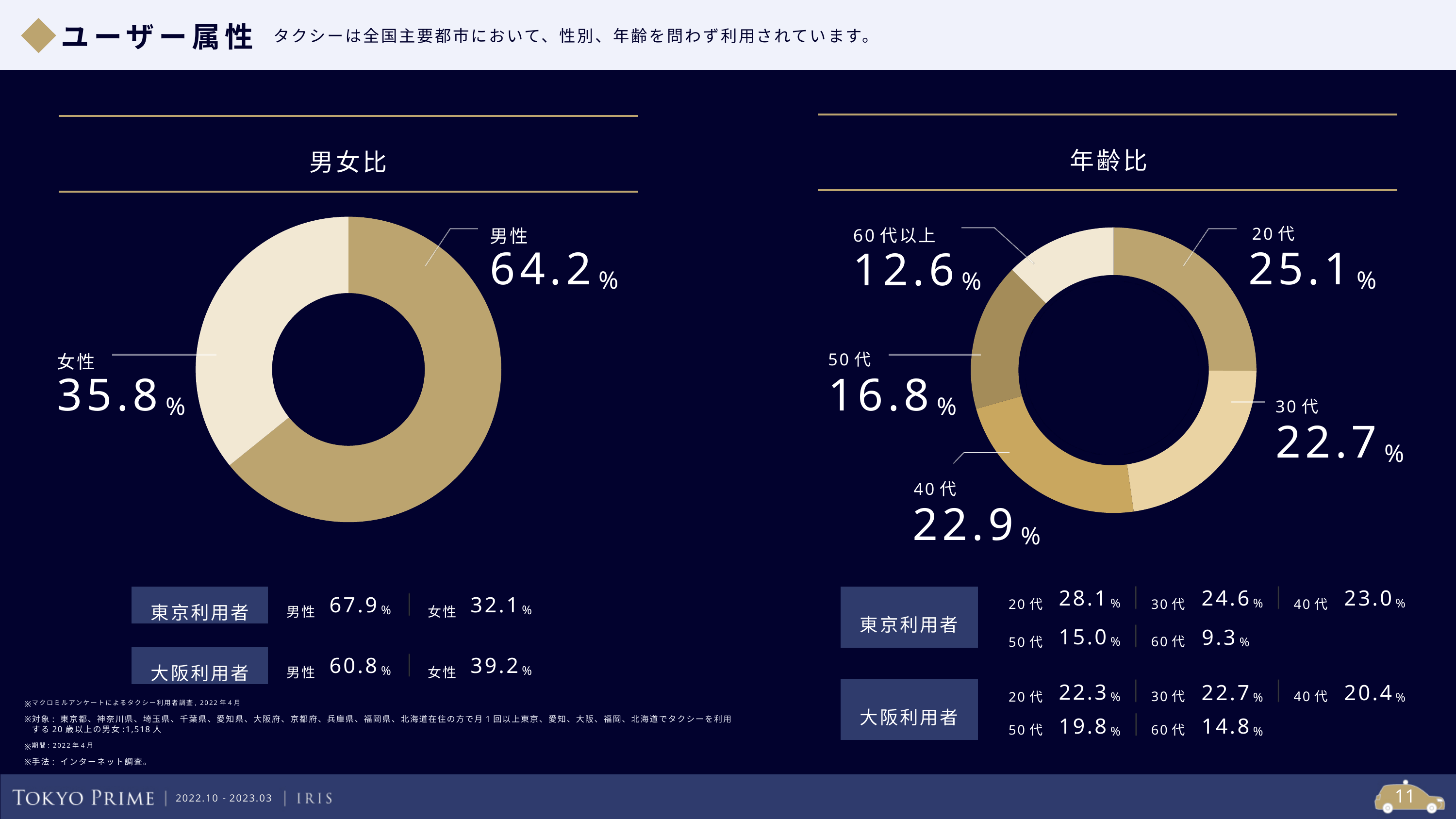
In the 男女比 chart, what is the value for 女性? 35.8% In the 年齢比 chart, what is the value for 50代? 16.8% In the 年齢比 chart, what is the value for 30代? 22.7% In the 年齢比 chart, which is larger, 20代 or 50代? 20代 In the 男女比 chart, how much larger is the 男性 share than the 女性 share? 28.4% What is the title of the chart on the left side of the slide? 男女比 In the 年齢比 chart, what is the difference between the 20代 and 60代以上 shares? 12.5% In the 男女比 chart, what is the value for 男性? 64.2% In the 年齢比 chart, which age group has the smallest share? 60代以上 What kind of chart is the 男女比 chart? donut (pie) chart In the 年齢比 chart, which age group has the largest share? 20代 How many age categories are shown in the 年齢比 chart? 5